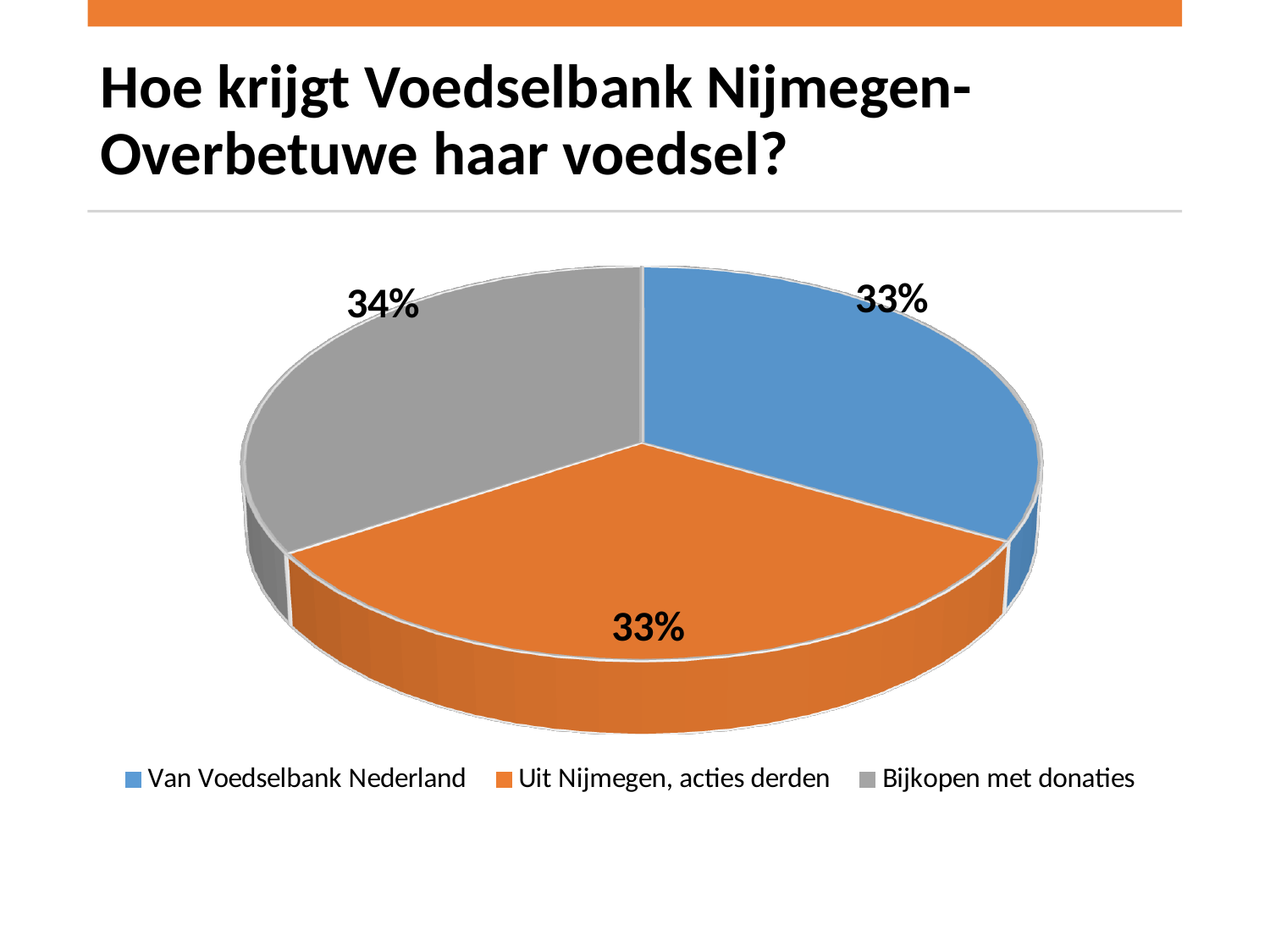
Which colour represents 'Uit Nijmegen, acties derden' in the pie chart? orange Which is larger: the slice for 'Bijkopen met donaties' or the slice for 'Uit Nijmegen, acties derden'? Bijkopen met donaties How many slices does the pie chart have? 3 What share of the pie does 'Uit Nijmegen, acties derden' represent? 33% What is the title of the slide containing the pie chart? Hoe krijgt Voedselbank Nijmegen-Overbetuwe haar voedsel? What is the difference in percentage points between 'Bijkopen met donaties' and 'Van Voedselbank Nederland'? 1 What share of the pie does 'Bijkopen met donaties' represent? 34% How many entries does the legend list? 3 Which category has the largest slice of the pie? Bijkopen met donaties What kind of chart is shown on the slide? pie chart What share of the pie does 'Van Voedselbank Nederland' represent? 33%